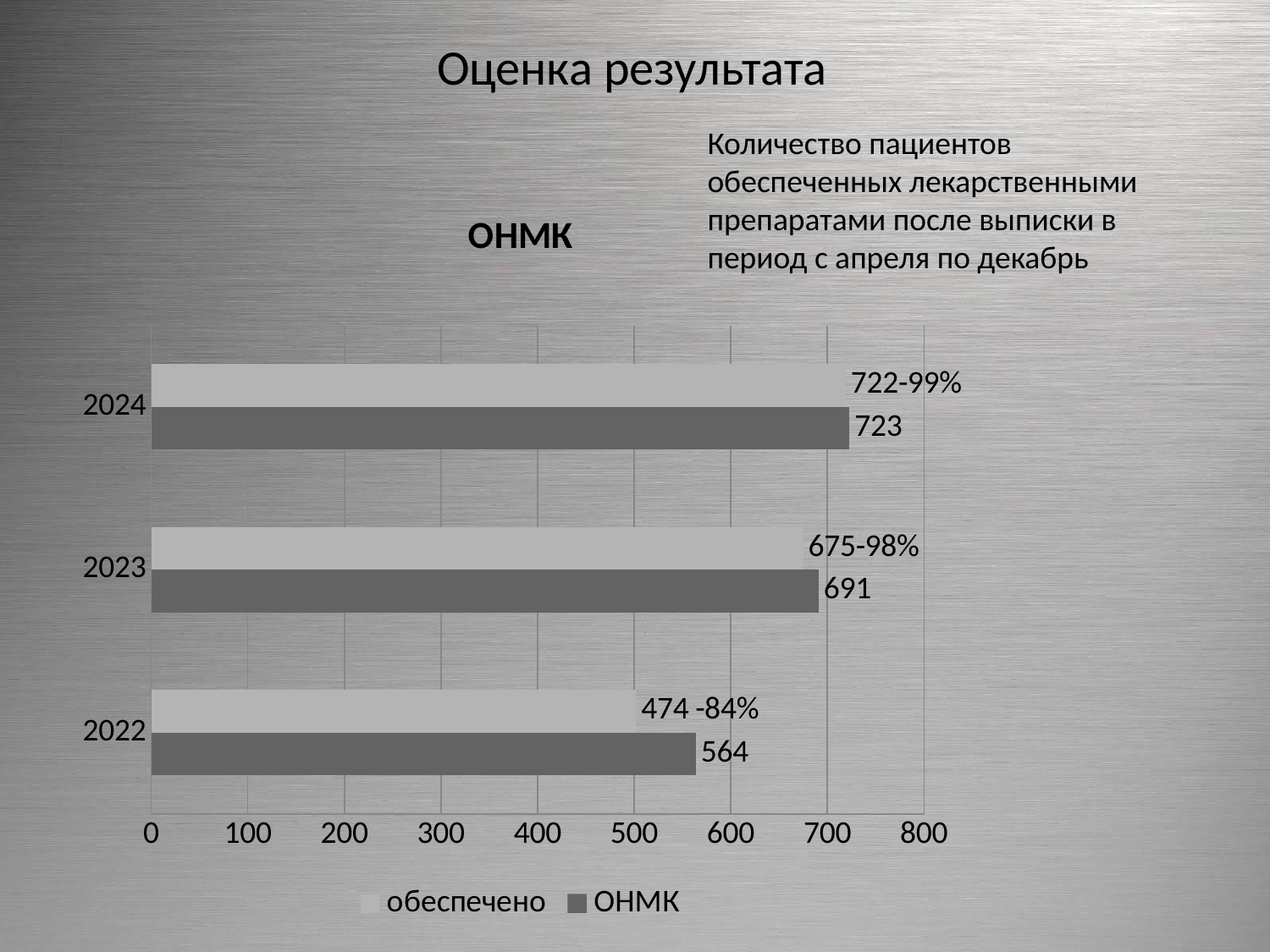
What data label is shown on the обеспечено bar for 2024? 722-99% What is the value of the ОНМК series for 2024? 723 What is the value of the ОНМК series for 2023? 691 Which is larger: the ОНМК value for 2023 or for 2022? 2023 Which year has the highest value in the ОНМК series? 2024 Which year has the lowest value in the ОНМК series? 2022 What is the difference between the ОНМК values for 2024 and 2022? 159 What is the value of the ОНМК series for 2022? 564 How many years are shown on the chart? 3 How many series does the legend list? 2 What type of chart is shown on the slide? Bar chart What data label is shown on the обеспечено bar for 2022? 474 -84%